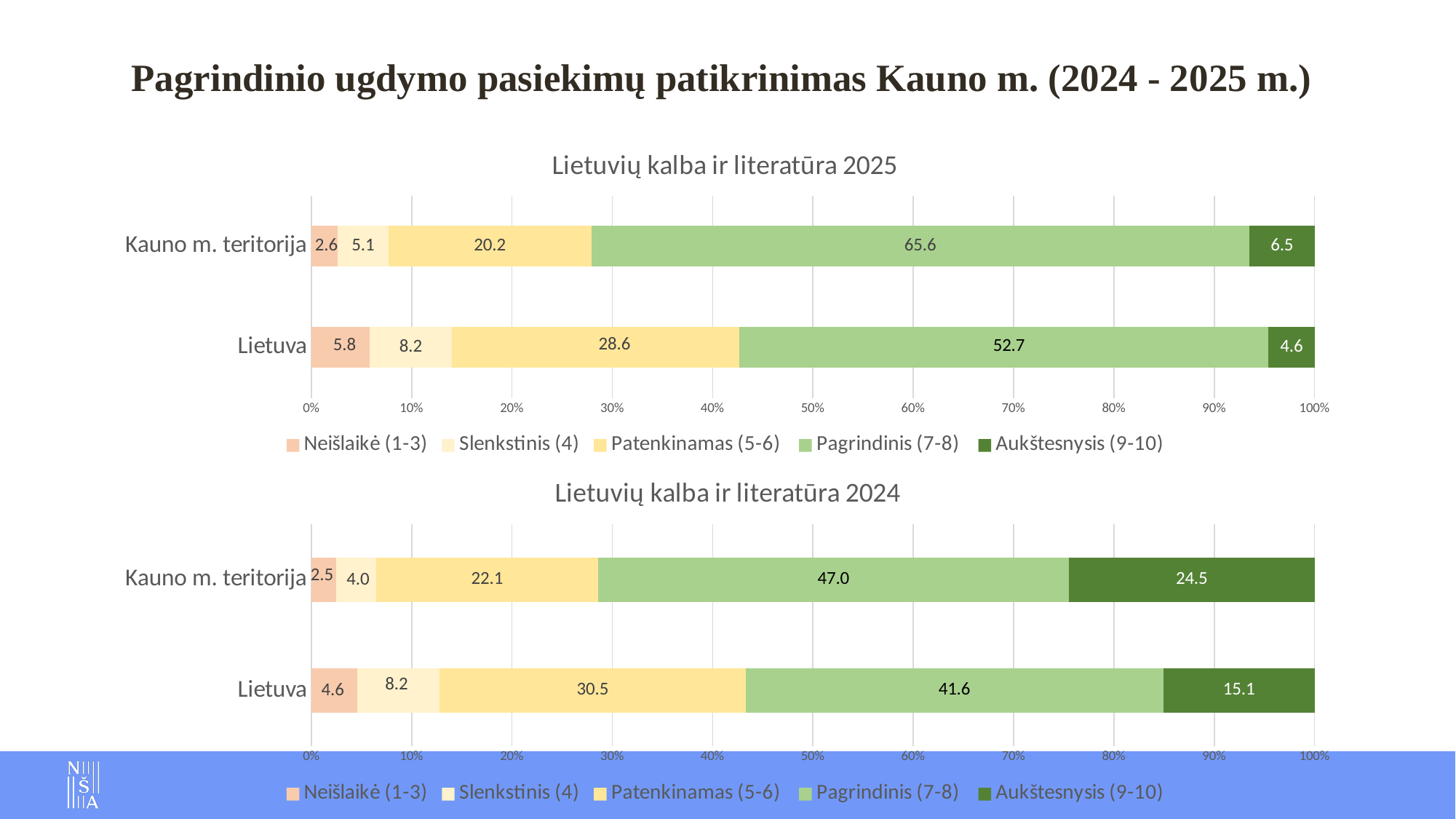
In the 'Lietuvių kalba ir literatūra 2025' chart, which series has the largest segment for Kauno m. teritorija? Pagrindinis (7-8) In the 'Lietuvių kalba ir literatūra 2025' chart, what is the value of Pagrindinis (7-8) for Kauno m. teritorija? 65.6 In the 'Lietuvių kalba ir literatūra 2024' chart, which is larger: Patenkinamas (5-6) for Lietuva or for Kauno m. teritorija? Lietuva How many series does the legend of the 'Lietuvių kalba ir literatūra 2025' chart list? 5 In the 'Lietuvių kalba ir literatūra 2025' chart, what is the difference between the Pagrindinis (7-8) values for Kauno m. teritorija and Lietuva? 12.9 In the 'Lietuvių kalba ir literatūra 2024' chart, what is the value of Neišlaikė (1-3) for Lietuva? 4.6 In the 'Lietuvių kalba ir literatūra 2024' chart, what is the value of Aukštesnysis (9-10) for Kauno m. teritorija? 24.5 In the 'Lietuvių kalba ir literatūra 2024' chart, which series has the smallest segment for Kauno m. teritorija? Neišlaikė (1-3) What kind of chart is the 'Lietuvių kalba ir literatūra 2024' chart? Stacked bar chart In the 'Lietuvių kalba ir literatūra 2025' chart, what is the value of Patenkinamas (5-6) for Lietuva? 28.6 How many categories are shown on the y axis of the 'Lietuvių kalba ir literatūra 2025' chart? 2 In the 'Lietuvių kalba ir literatūra 2024' chart, what is the difference between the Aukštesnysis (9-10) values for Kauno m. teritorija and Lietuva? 9.4